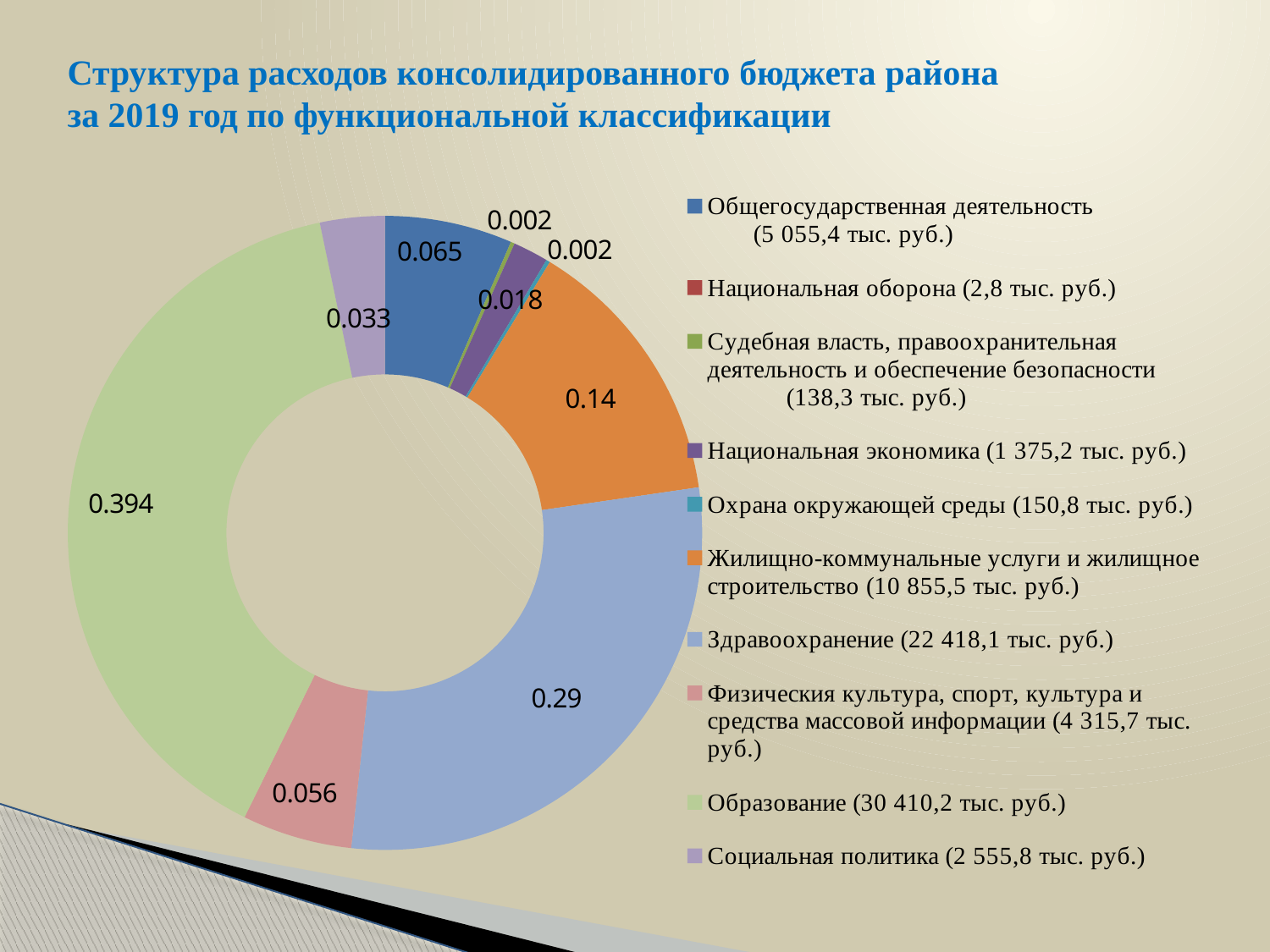
What is the difference between the shares of Образование and Здравоохранение? 0.104 Which is larger, the share for Физическая культура, спорт, культура и средства массовой информации or the share for Общегосударственная деятельность? Общегосударственная деятельность How many categories does the legend list? 10 What is the value shown for Здравоохранение? 0.29 According to the legend, how many thousand rubles were spent on Образование? 30 410,2 тыс. руб. What share of expenditures does Образование account for? 0.394 What is the value shown for Национальная экономика? 0.018 What is the value shown for Общегосударственная деятельность? 0.065 What is the value shown for Социальная политика? 0.033 Which category has the largest share of the chart? Образование What kind of chart is shown on the slide? Doughnut (pie) chart What is the value shown for Жилищно-коммунальные услуги и жилищное строительство? 0.14